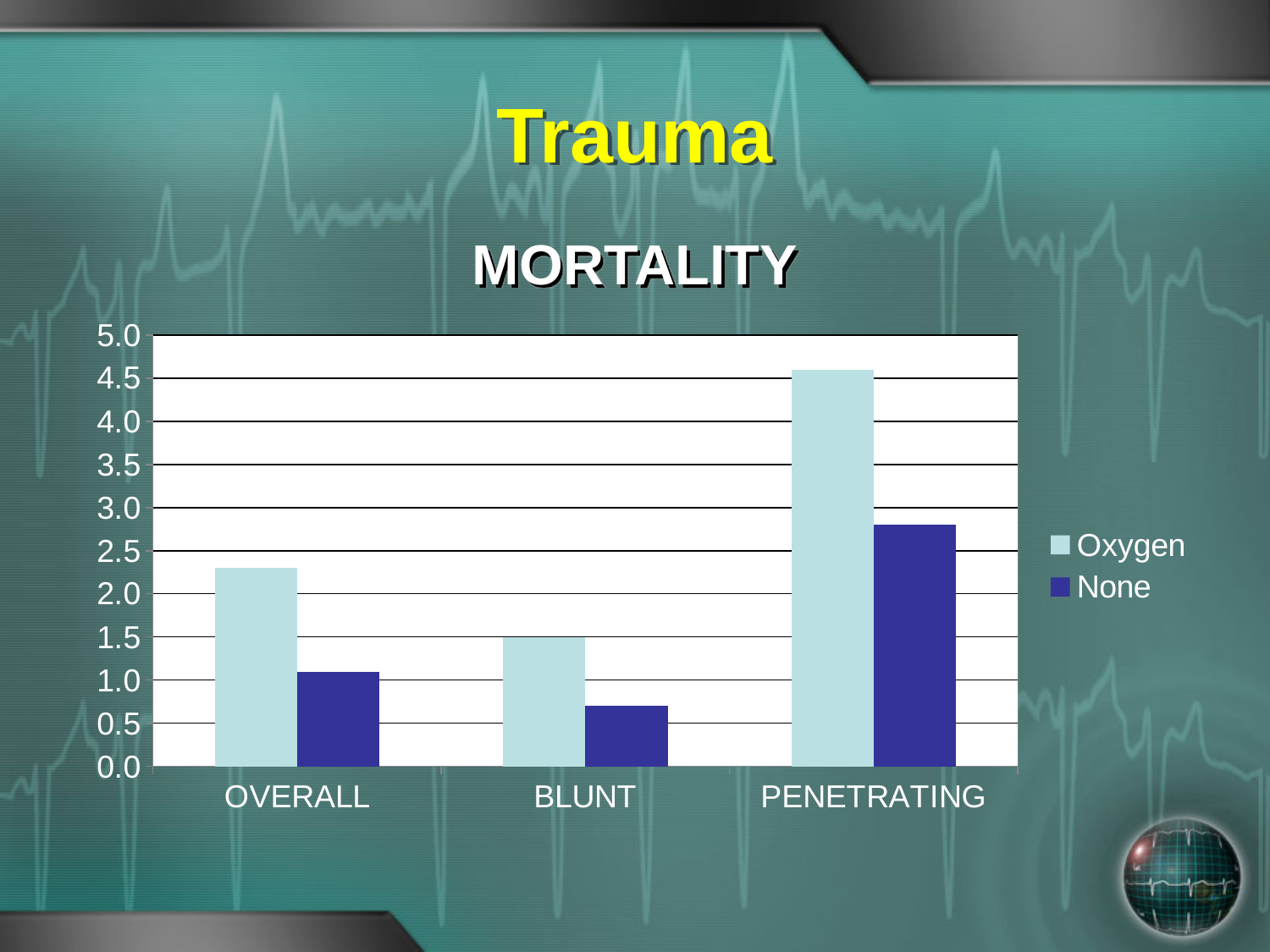
Is the Oxygen value for PENETRATING greater or less than 4.0? greater Which category has the highest Oxygen bar? PENETRATING Is the Oxygen value for OVERALL greater or less than 2.0? greater What is the title of the chart? MORTALITY Is the None value for PENETRATING greater or less than 3.0? less Which category has the lowest None bar? BLUNT What kind of chart is shown on the slide? bar chart In every category, which series has the taller bar, Oxygen or None? Oxygen Which is larger, the Oxygen value for OVERALL or the Oxygen value for BLUNT? OVERALL How many categories are shown on the x axis of the chart? 3 How many series does the chart's legend list? 2